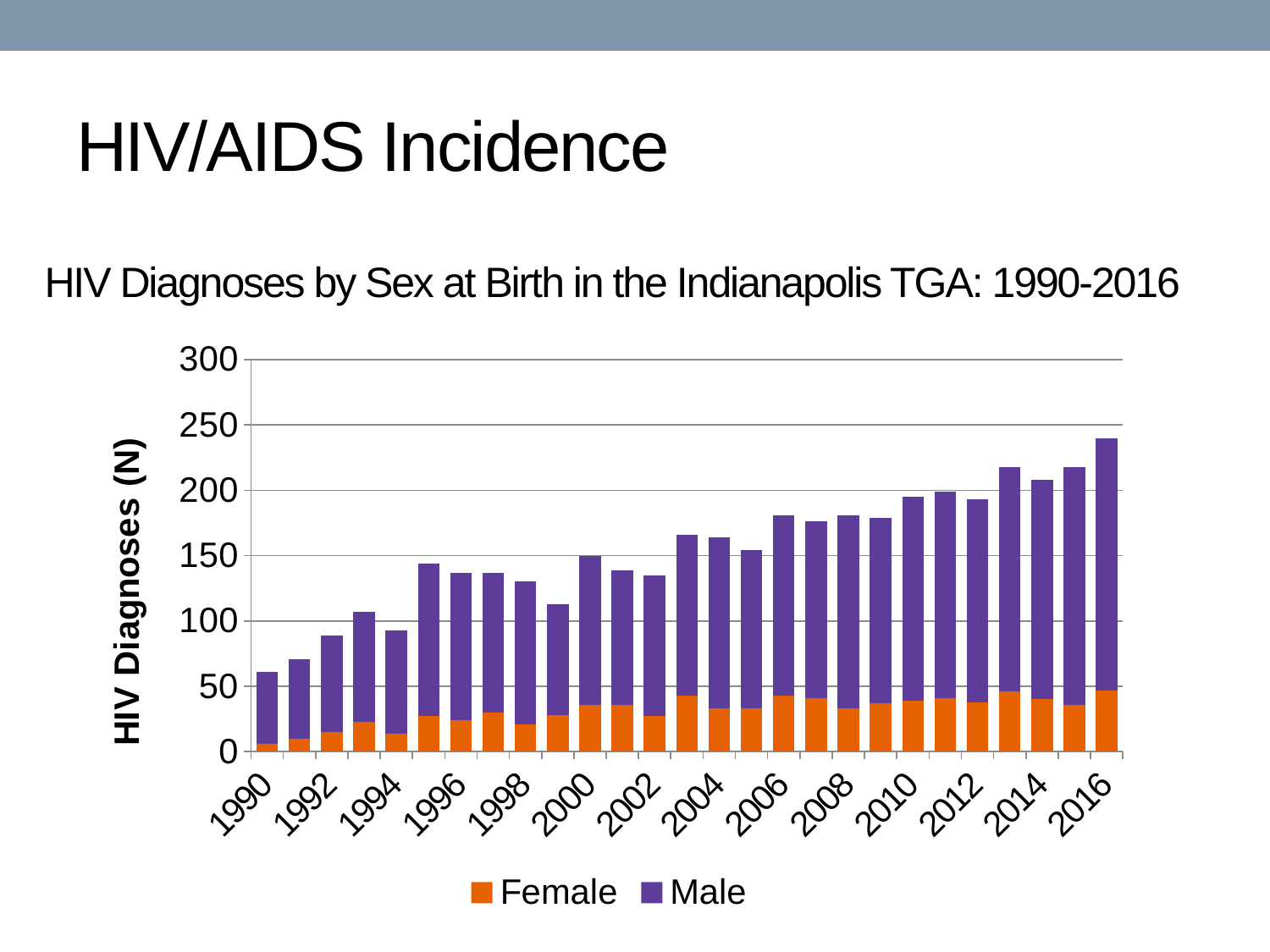
Is the total number of HIV diagnoses in 1990 greater or less than 100? less Which year has the lowest total number of HIV diagnoses? 1990 Which two series are shown in the legend? Female and Male Is the total number of HIV diagnoses in 2016 greater or less than 200? greater What kind of chart is shown on the slide? Stacked bar chart Is the total number of HIV diagnoses in 2008 greater or less than 200? less Which year has the highest total number of HIV diagnoses? 2016 How many series does the legend list? 2 Overall, do total HIV diagnoses rise or fall from 1990 to 2016? rise What is the label on the vertical axis? HIV Diagnoses (N) How many years (bars) are plotted in the chart? 27